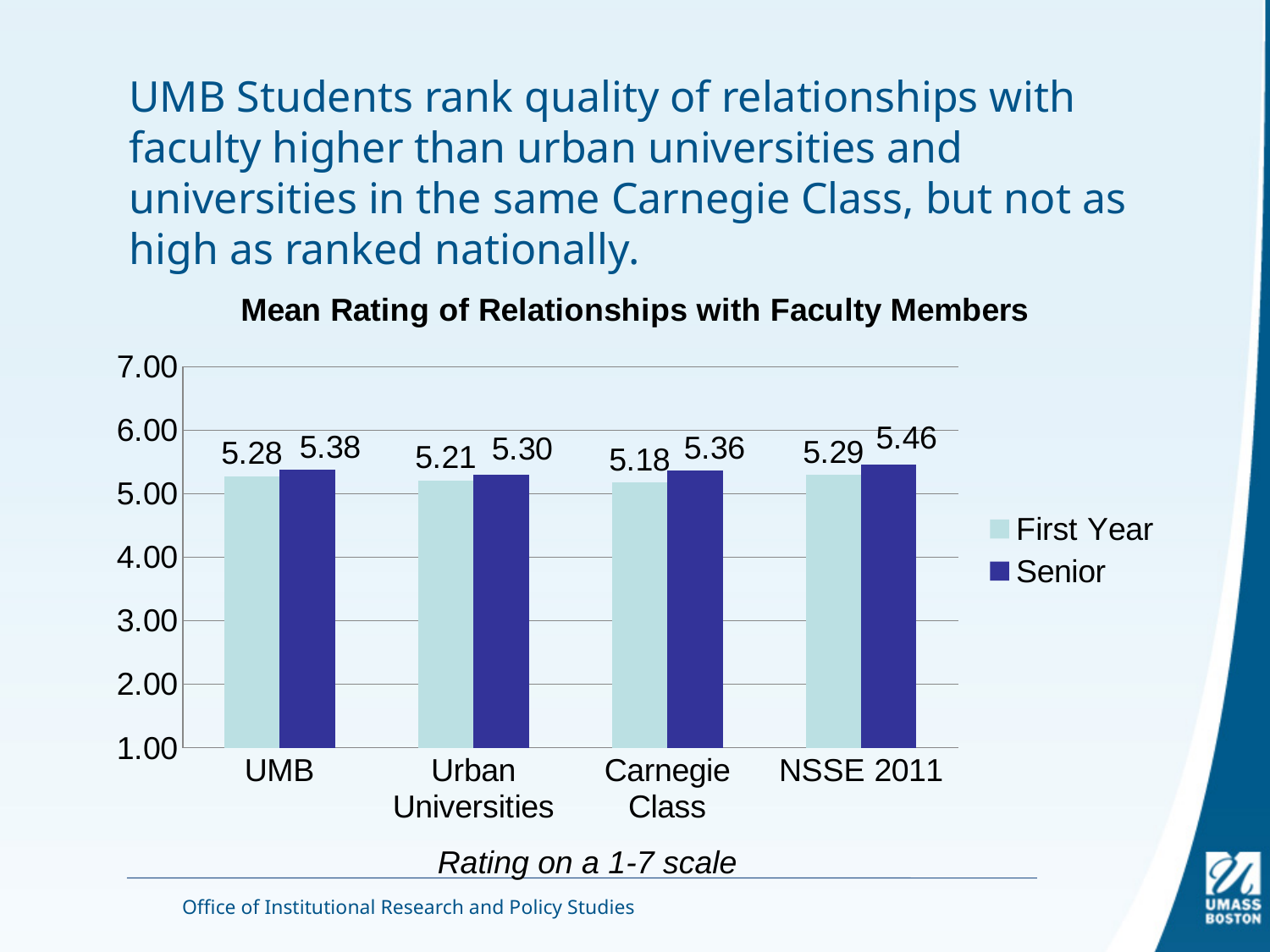
What is the Senior mean rating for Carnegie Class? 5.36 How many series does the legend list? 2 What is the title of the chart? Mean Rating of Relationships with Faculty Members What is the First Year mean rating for UMB? 5.28 Which category has the highest Senior rating? NSSE 2011 What is the First Year mean rating for Urban Universities? 5.21 What kind of chart is shown on the slide? Bar chart What is the difference between the Senior and First Year ratings for Carnegie Class? 0.18 Which category has the lowest First Year rating? Carnegie Class How many categories are shown on the x axis? 4 Which is larger, the Senior rating for UMB or the Senior rating for Urban Universities? UMB What is the Senior mean rating for NSSE 2011? 5.46